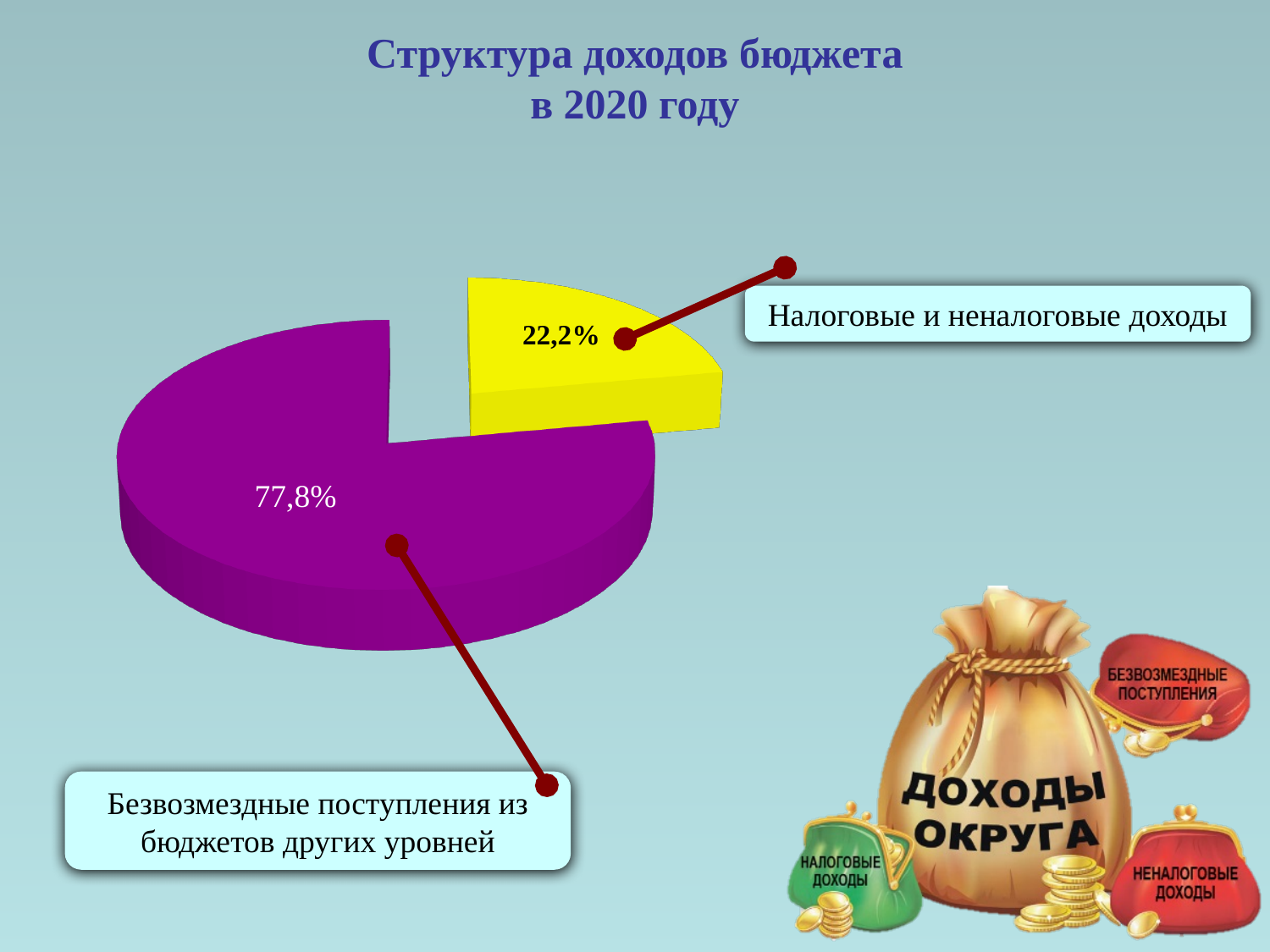
Which category has the smallest share of the pie? Налоговые и неналоговые доходы What share of the pie is labelled 'Налоговые и неналоговые доходы'? 22,2% What is the title of the chart on the slide? Структура доходов бюджета в 2020 году Is the share for 'Налоговые и неналоговые доходы' greater or less than 25%? less What is the difference in percentage points between the two slices of the pie? 55,6 Which is larger: the share for 'Налоговые и неналоговые доходы' or the share for 'Безвозмездные поступления из бюджетов других уровней'? Безвозмездные поступления из бюджетов других уровней What share of the pie is labelled 'Безвозмездные поступления из бюджетов других уровней'? 77,8% What kind of chart is shown on the slide? Pie chart What is the total of the two slices shown in the pie chart? 100% Which category has the largest share of the pie? Безвозмездные поступления из бюджетов других уровней What colour is the slice for 'Налоговые и неналоговые доходы'? Yellow How many slices does the pie chart have? 2